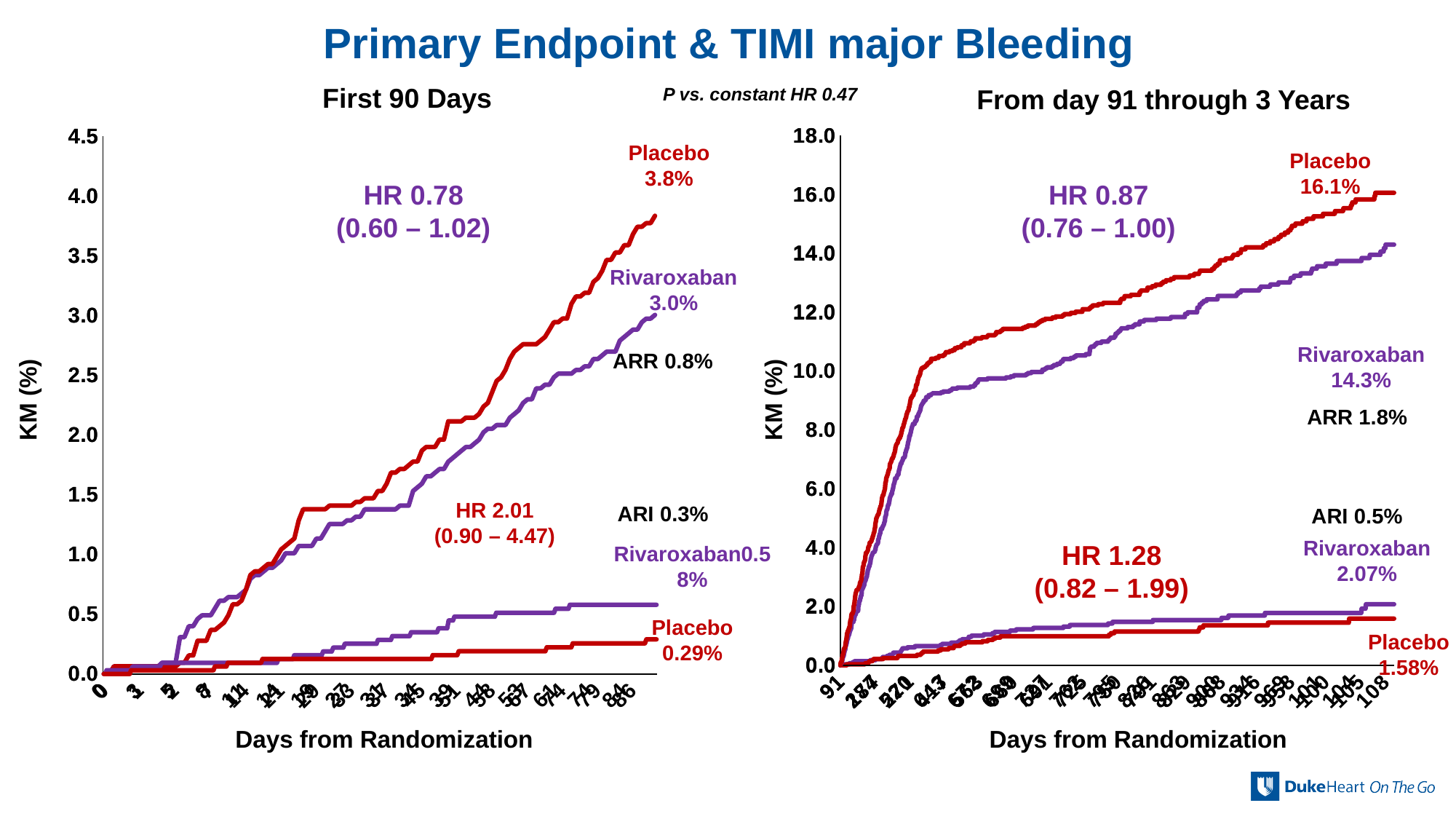
In the 'From day 91 through 3 Years' chart, what is the KM value printed for Rivaroxaban for the primary endpoint? 14.3% In the 'First 90 Days' chart, what is the difference between the Placebo (3.8%) and Rivaroxaban (3.0%) primary endpoint values? 0.8% In the 'From day 91 through 3 Years' chart, what is the KM value printed for Placebo for the primary endpoint? 16.1% In the 'From day 91 through 3 Years' chart, which primary endpoint curve ends higher, Placebo or Rivaroxaban? Placebo In the 'From day 91 through 3 Years' chart, what is the KM value printed for Rivaroxaban for TIMI major bleeding? 2.07% In the 'First 90 Days' chart, what is the KM value printed for Placebo for the primary endpoint? 3.8% In the 'First 90 Days' chart, what is the hazard ratio printed for the primary endpoint? HR 0.78 (0.60 – 1.02) In the 'First 90 Days' chart, what is the KM value printed for Rivaroxaban for the primary endpoint? 3.0% In the 'From day 91 through 3 Years' chart, what is the difference between the Rivaroxaban (2.07%) and Placebo (1.58%) bleeding values? 0.49% In the 'From day 91 through 3 Years' chart, do the primary endpoint curves rise or fall as days from randomization increase? Rise What kind of chart is shown in the 'First 90 Days' panel? Line chart In the 'First 90 Days' chart, what is the KM value printed for Placebo for TIMI major bleeding? 0.29%